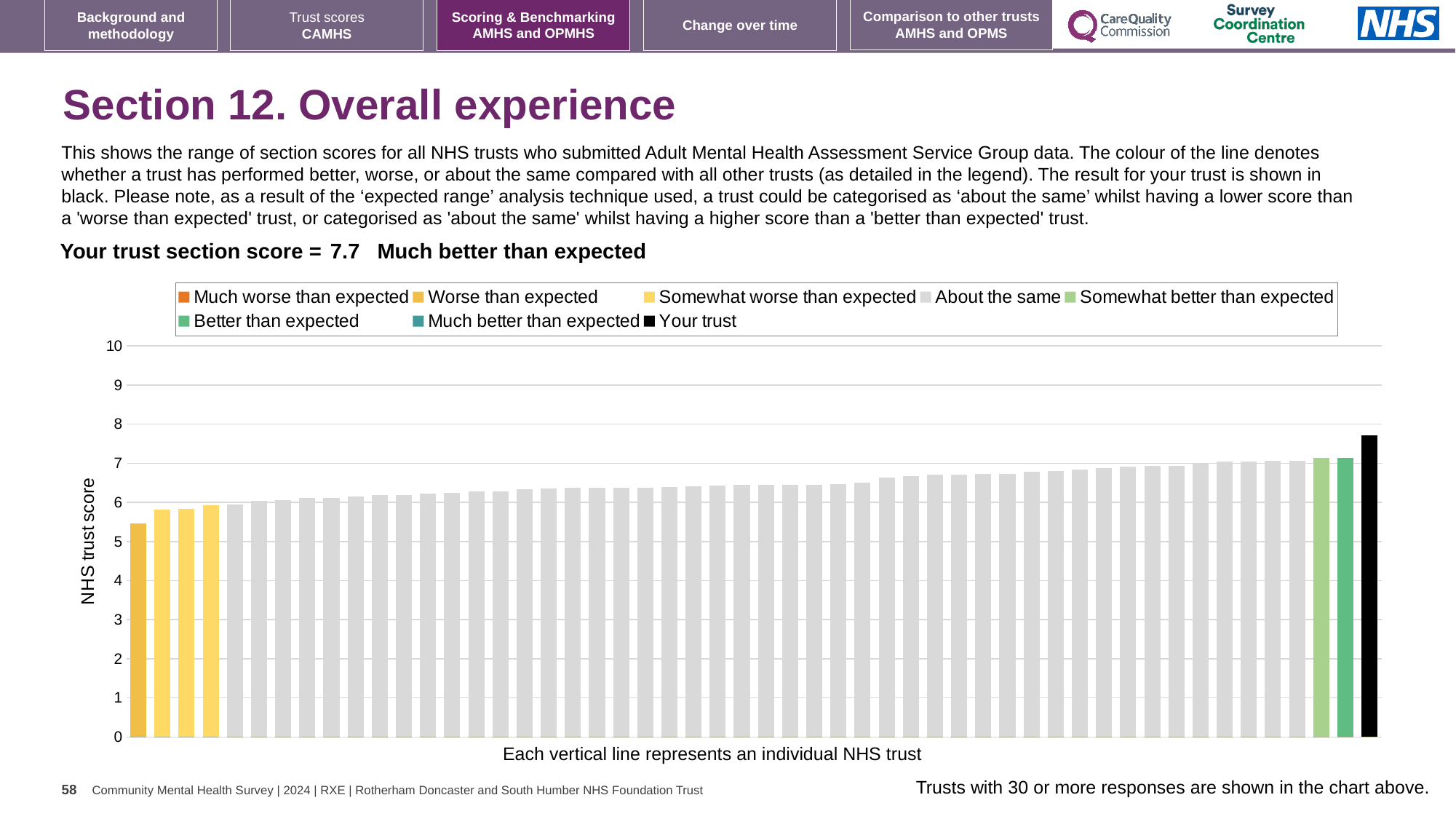
What kind of chart is shown on the slide? bar chart How many bars in the chart are coloured black? 1 What is the section score for your trust shown on the slide? 7.7 Is the value of the black 'Your trust' bar greater or less than 7? greater How many bars in the chart are coloured green (somewhat better or better than expected)? 2 What is the label on the vertical axis of the chart? NHS trust score Do the bar values rise or fall from left to right along the x axis? rise Which bar in the chart is the highest? Your trust (the black bar) Is the value of the lowest bar in the chart greater or less than 6? less How many entries does the chart legend list? 8 Is the value of the lowest bar in the chart greater or less than 5? greater According to the legend, what does the black bar represent? Your trust